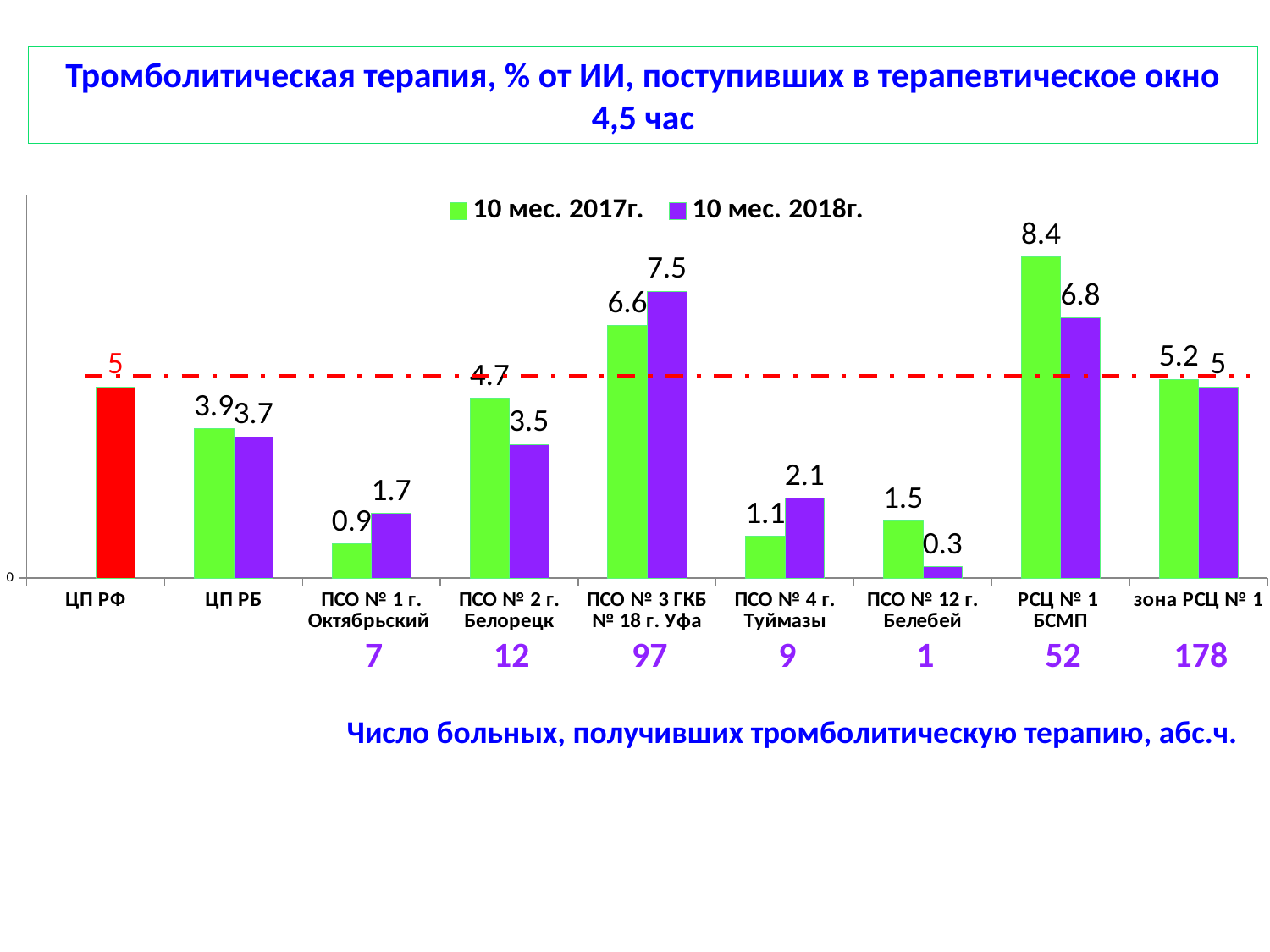
What is the difference between the 10 мес. 2017г. and 10 мес. 2018г. values for ПСО № 2 г. Белорецк? 1.2 How many series does the legend list? 2 What is the value for ПСО № 3 ГКБ № 18 г. Уфа in the 10 мес. 2018г. series? 7.5 Which category has the lowest value in the 10 мес. 2018г. series? ПСО № 12 г. Белебей What is the value for ПСО № 12 г. Белебей in the 10 мес. 2018г. series? 0.3 What number is printed below the РСЦ № 1 БСМП category as the number of patients who received thrombolytic therapy? 52 What is the value for РСЦ № 1 БСМП in the 10 мес. 2017г. series? 8.4 Which is larger for ПСО № 4 г. Туймазы: the 10 мес. 2017г. value or the 10 мес. 2018г. value? 10 мес. 2018г. Which category has the highest value in the 10 мес. 2017г. series? РСЦ № 1 БСМП What value is marked by the red dashed horizontal line? 5 What kind of chart is shown on the slide? Bar chart How many categories are shown on the x axis? 9